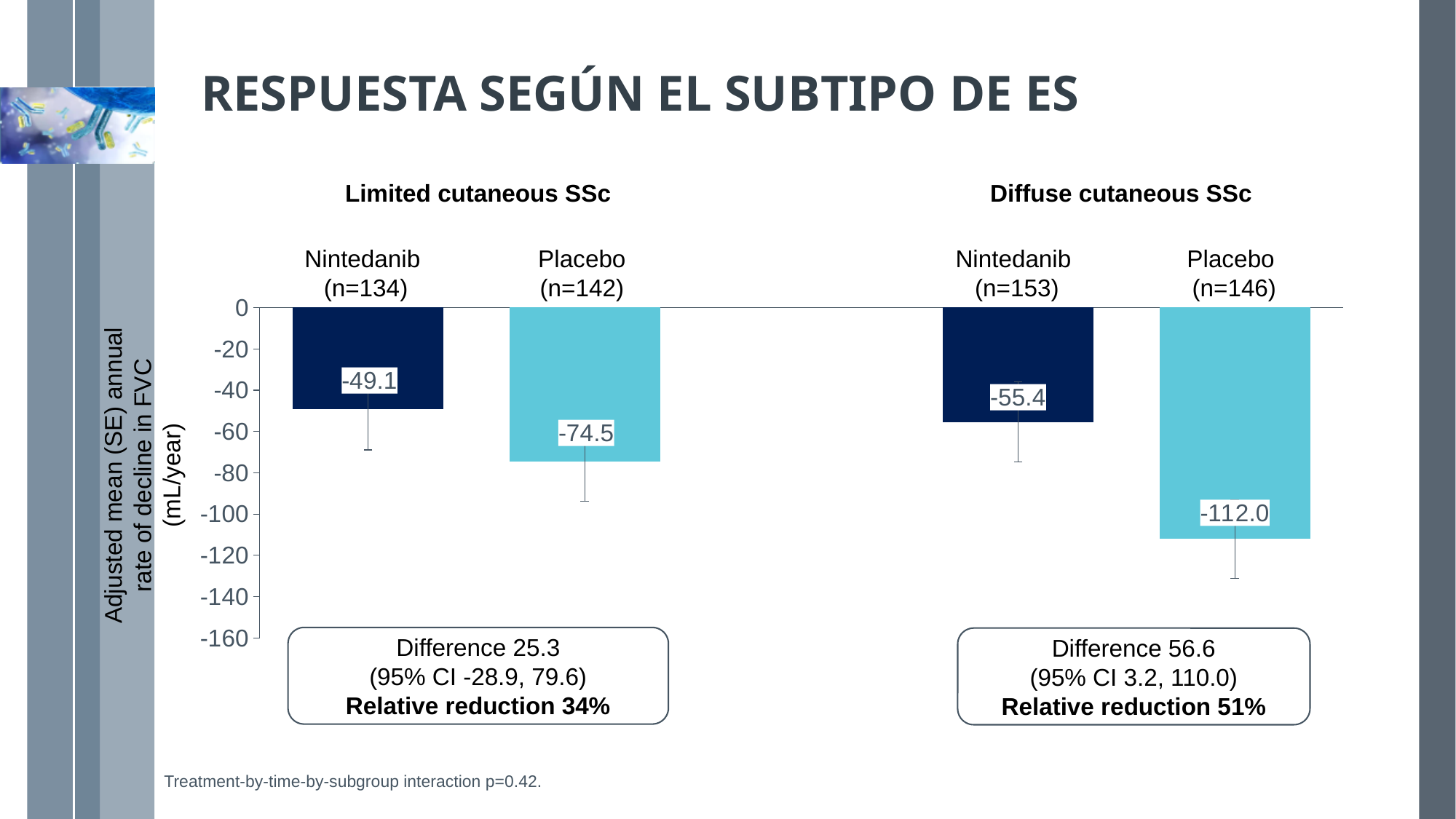
Which bar shows the smallest decline in FVC (the value closest to 0)? Nintedanib (n=134) in Limited cutaneous SSc What is the adjusted mean annual rate of decline in FVC for Nintedanib in the Limited cutaneous SSc group? -49.1 What is the value shown for Placebo in the Limited cutaneous SSc group? -74.5 What is the y-axis label of the chart? Adjusted mean (SE) annual rate of decline in FVC (mL/year) What is the difference between the Placebo and Nintedanib values in the Diffuse cutaneous SSc group? 56.6 What is the adjusted mean annual rate of decline in FVC for Placebo in the Diffuse cutaneous SSc group? -112.0 Which bar shows the largest decline in FVC (the lowest value)? Placebo (n=146) in Diffuse cutaneous SSc What is the difference between the Placebo and Nintedanib values in the Limited cutaneous SSc group? 25.4 Which shows a greater decline in FVC: Placebo in Limited cutaneous SSc or Placebo in Diffuse cutaneous SSc? Placebo in Diffuse cutaneous SSc How many bars are plotted on the chart? 4 What kind of chart is shown on the slide? Bar chart What is the value shown for Nintedanib in the Diffuse cutaneous SSc group? -55.4